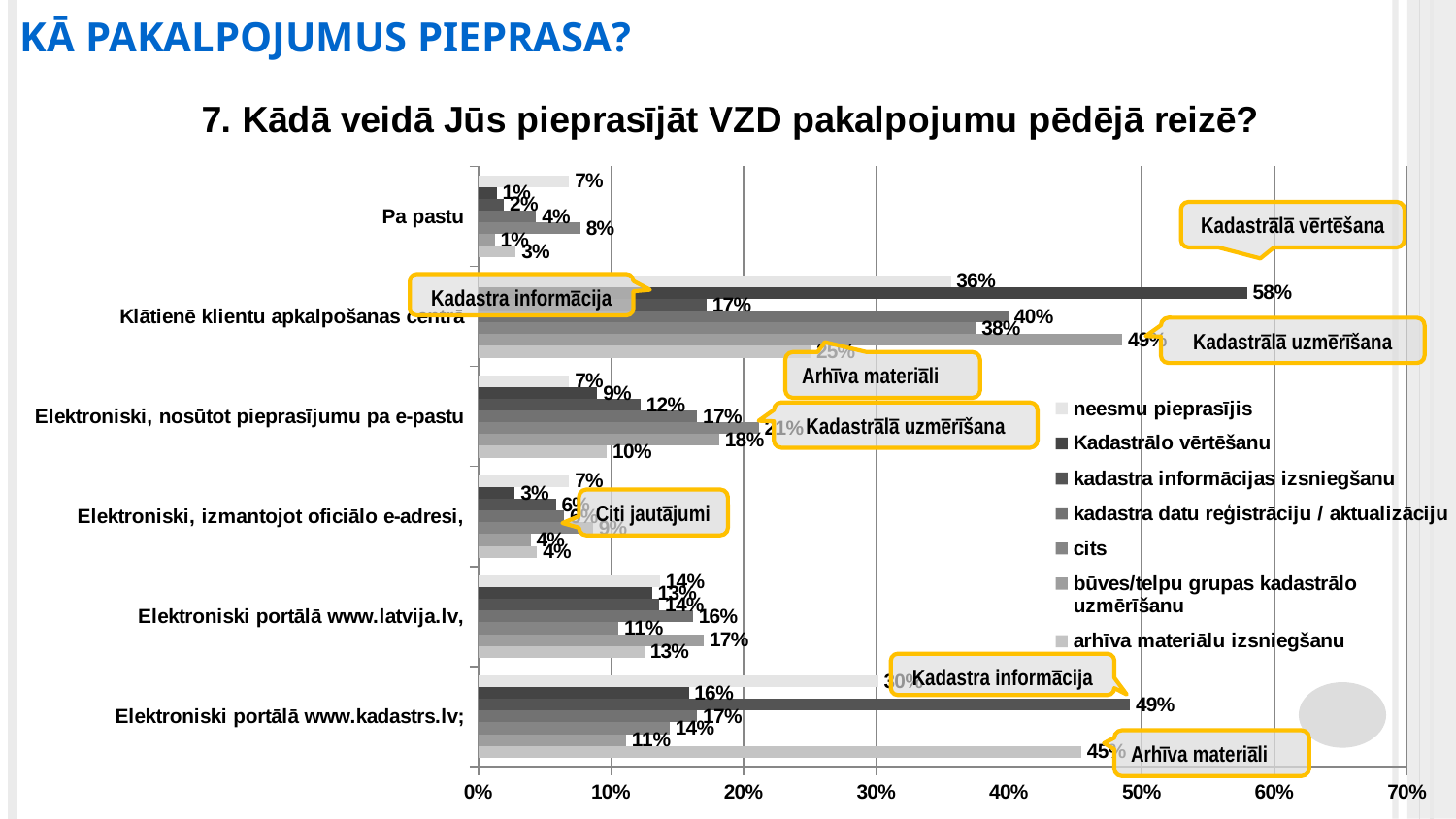
Which series has the lowest value in the 'Klātienē klientu apkalpošanas centrā' category? kadastra informācijas izsniegšanu What is the value for 'kadastra informācijas izsniegšanu' in the 'Elektroniski portālā www.kadastrs.lv' category? 49% In the 'Elektroniski portālā www.kadastrs.lv' category, which is larger: 'neesmu pieprasījis' or 'Kadastrālo vērtēšanu'? neesmu pieprasījis What is the difference between 'Kadastrālo vērtēšanu' (58%) and 'neesmu pieprasījis' (36%) in the 'Klātienē klientu apkalpošanas centrā' category? 22 percentage points How many categories are shown on the y axis of the chart? 6 Which series has the highest value in the 'Klātienē klientu apkalpošanas centrā' category? Kadastrālo vērtēšanu What kind of chart is shown on the slide? Bar chart Is the value for 'būves/telpu grupas kadastrālo uzmērīšanu' in the 'Klātienē klientu apkalpošanas centrā' category greater or less than 40%? greater How many series does the legend list? 7 What is the value for 'arhīva materiālu izsniegšanu' in the 'Elektroniski portālā www.kadastrs.lv' category? 45% What is the value for 'Kadastrālo vērtēšanu' in the 'Klātienē klientu apkalpošanas centrā' category? 58% What is the value for 'neesmu pieprasījis' in the 'Pa pastu' category? 7%